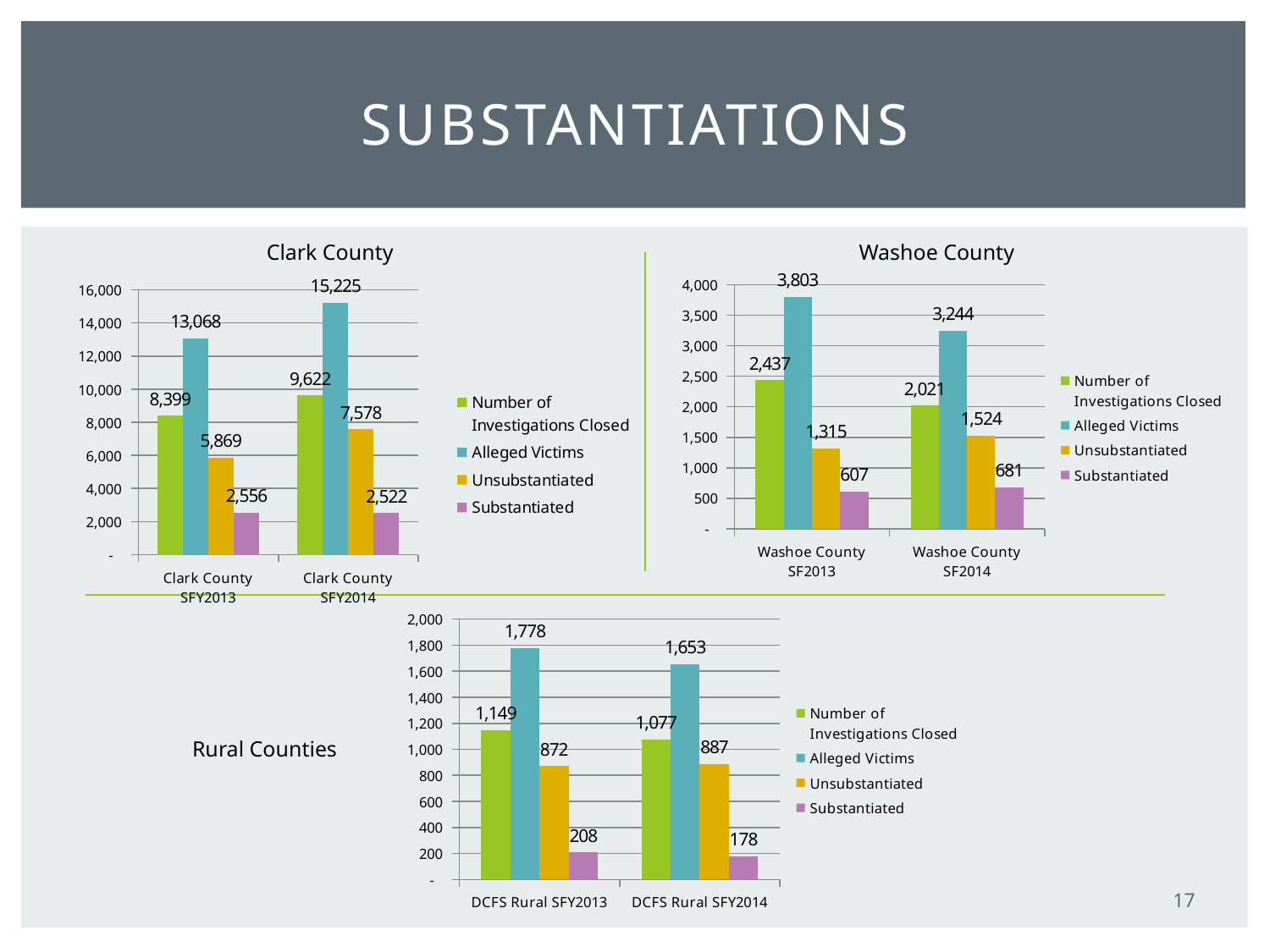
In the Clark County chart, what is the difference between the Number of Investigations Closed in SFY2014 and SFY2013? 1,223 What kind of chart is the Washoe County chart? bar chart In the Rural Counties chart, what is the difference between the Substantiated values for DCFS Rural SFY2013 and DCFS Rural SFY2014? 30 In the Clark County chart, what is the number of Alleged Victims for Clark County SFY2014? 15,225 In the Washoe County chart, is the Substantiated value for SF2013 greater or less than the Substantiated value for SF2014? less In the Washoe County chart, which series has the highest value for Washoe County SF2013? Alleged Victims In the Clark County chart, what is the Substantiated value for Clark County SFY2013? 2,556 In the Rural Counties chart, what is the Alleged Victims value for DCFS Rural SFY2013? 1,778 In the Rural Counties chart, which series has the lowest value for DCFS Rural SFY2014? Substantiated In the Washoe County chart, what is the Unsubstantiated value for Washoe County SF2014? 1,524 In the Rural Counties chart, does the Number of Investigations Closed rise or fall from SFY2013 to SFY2014? fall How many series does the legend of the Clark County chart list? 4